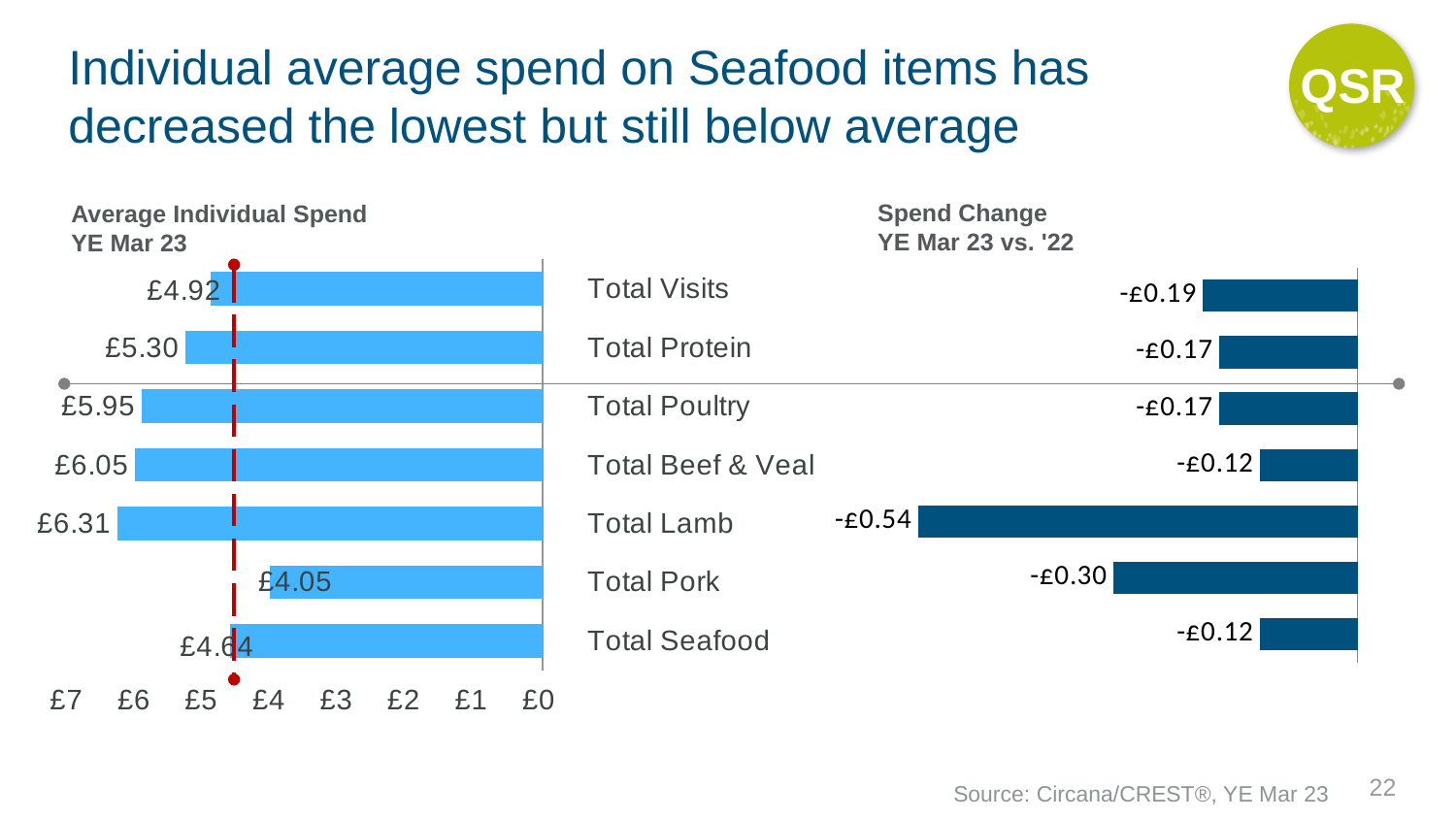
In the Spend Change YE Mar 23 vs. '22 chart, which category shows the largest decrease? Total Lamb In the Average Individual Spend YE Mar 23 chart, what is the difference between Total Beef & Veal and Total Poultry? £0.10 In the Average Individual Spend YE Mar 23 chart, which category has the lowest average spend? Total Pork In the Average Individual Spend YE Mar 23 chart, what is the value for Total Pork? £4.05 How many categories are shown in the Average Individual Spend YE Mar 23 chart? 7 In the Average Individual Spend YE Mar 23 chart, is the value for Total Protein greater or less than £5? greater In the Spend Change YE Mar 23 vs. '22 chart, what is the value for Total Visits? -£0.19 In the Average Individual Spend YE Mar 23 chart, which category has the highest average spend? Total Lamb What kind of chart is the Spend Change YE Mar 23 vs. '22 chart? Bar chart In the Average Individual Spend YE Mar 23 chart, what is the value for Total Lamb? £6.31 In the Spend Change YE Mar 23 vs. '22 chart, which has a larger decrease, Total Pork or Total Seafood? Total Pork In the Spend Change YE Mar 23 vs. '22 chart, what is the value for Total Lamb? -£0.54